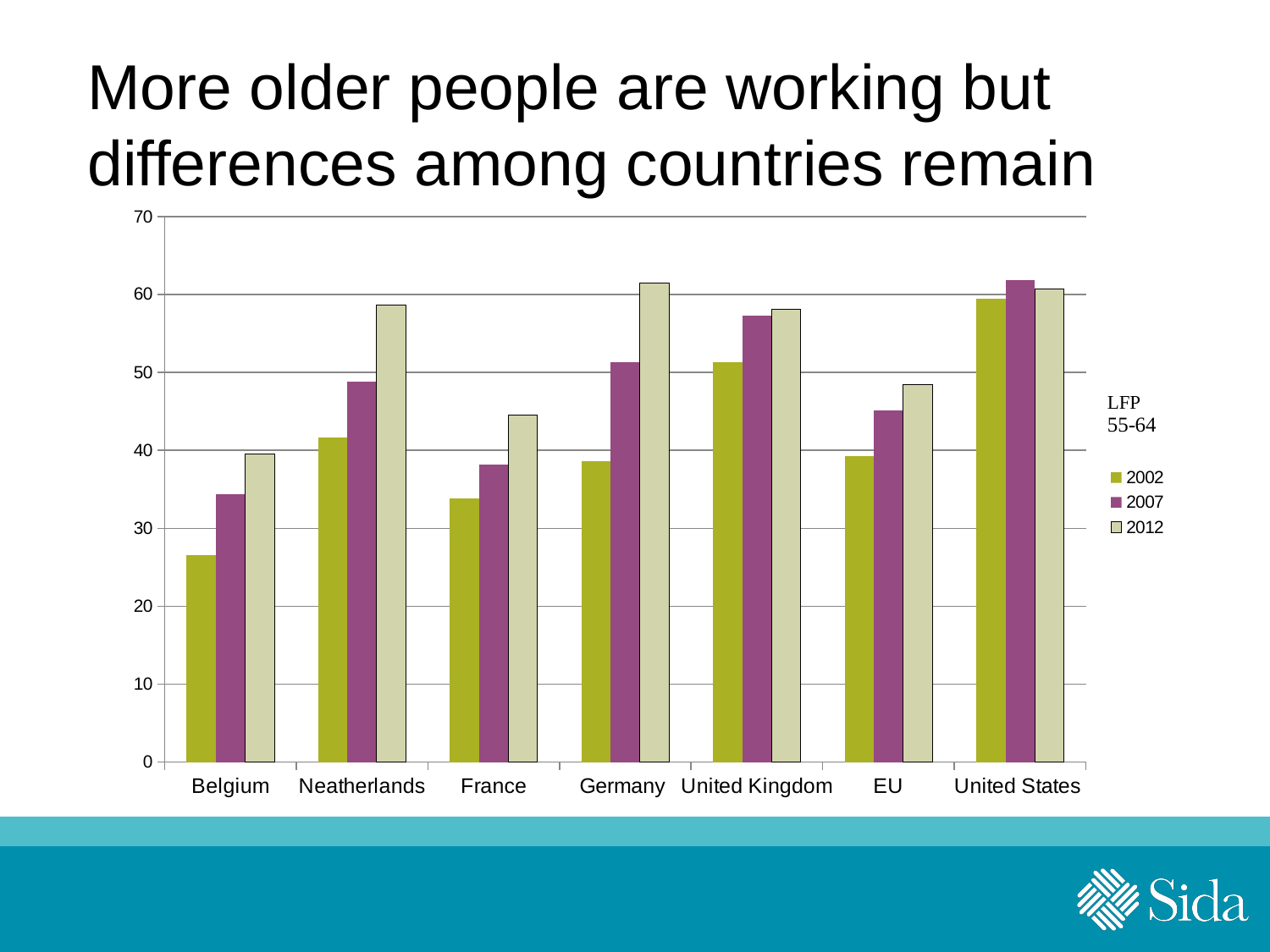
Do the values for Belgium rise or fall from 2002 to 2012? rise Which country has the highest value for 2002? United States Which is larger, the 2007 value for Germany or the 2007 value for France? Germany Which category has the lowest value for 2012? Belgium Is the value for France in 2007 greater or less than 40? less Which country has the lowest value for 2002? Belgium Is the value for Germany in 2012 greater or less than 60? greater Is the value for Belgium in 2002 greater or less than 30? less What are the three years listed in the chart's legend? 2002, 2007, 2012 How many series does the chart's legend list? 3 What kind of chart is shown on the slide? bar chart How many countries or regions are shown on the x axis of the chart? 7